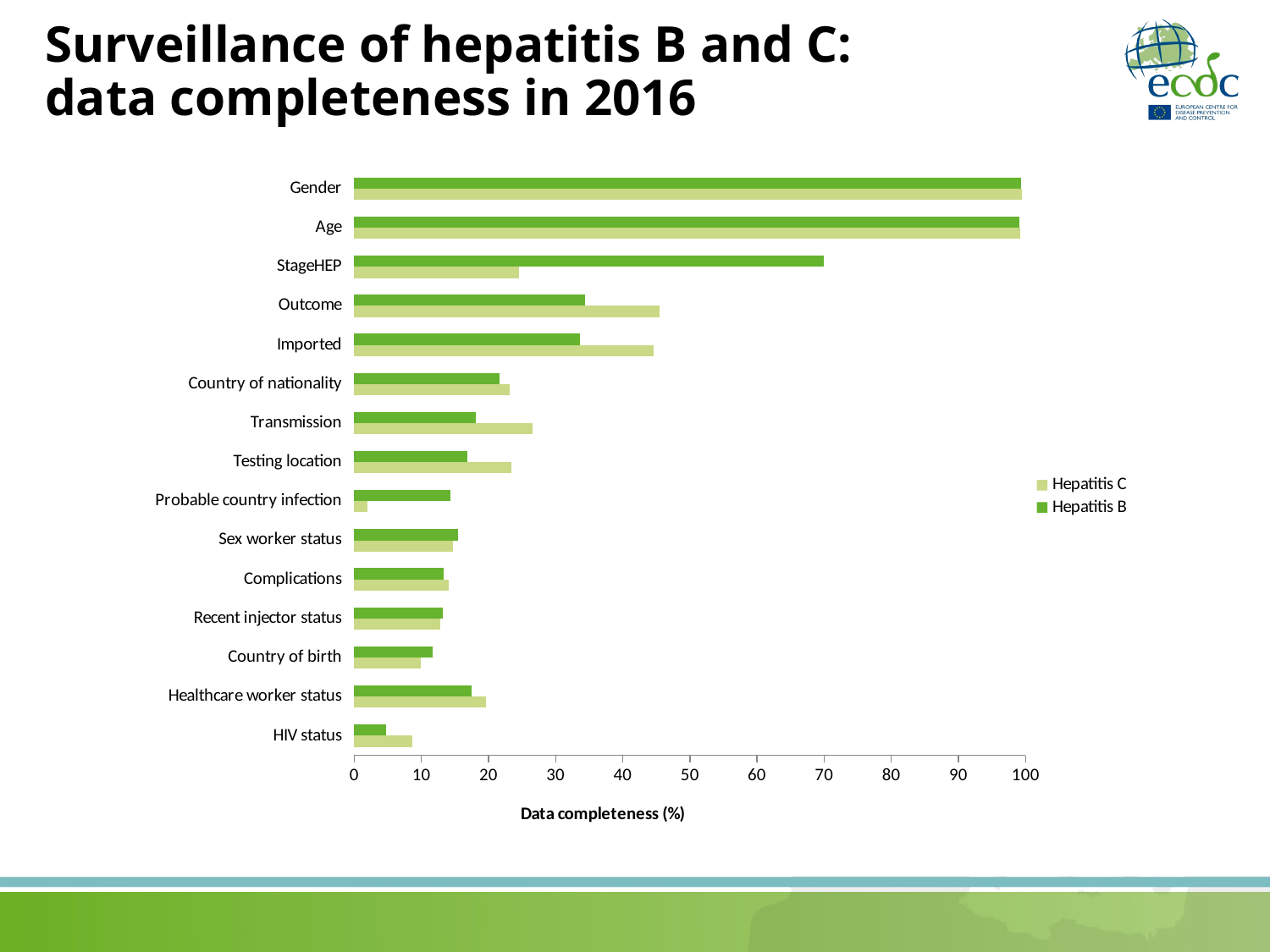
For Probable country infection, which series has the larger value, Hepatitis B or Hepatitis C? Hepatitis B How many variables (categories) are plotted on the y axis? 15 Is the Hepatitis B value for StageHEP greater or less than 60? greater Is the Hepatitis C value for Imported greater or less than 40? greater What kind of chart is shown on the slide? bar chart Which variable has the lowest Hepatitis B data completeness? HIV status Is the Hepatitis C value for StageHEP greater or less than 30? less Which variable has the lowest Hepatitis C data completeness? Probable country infection For Outcome, which series has the larger value, Hepatitis B or Hepatitis C? Hepatitis C How many series does the legend list? 2 For StageHEP, which series has the larger value, Hepatitis B or Hepatitis C? Hepatitis B